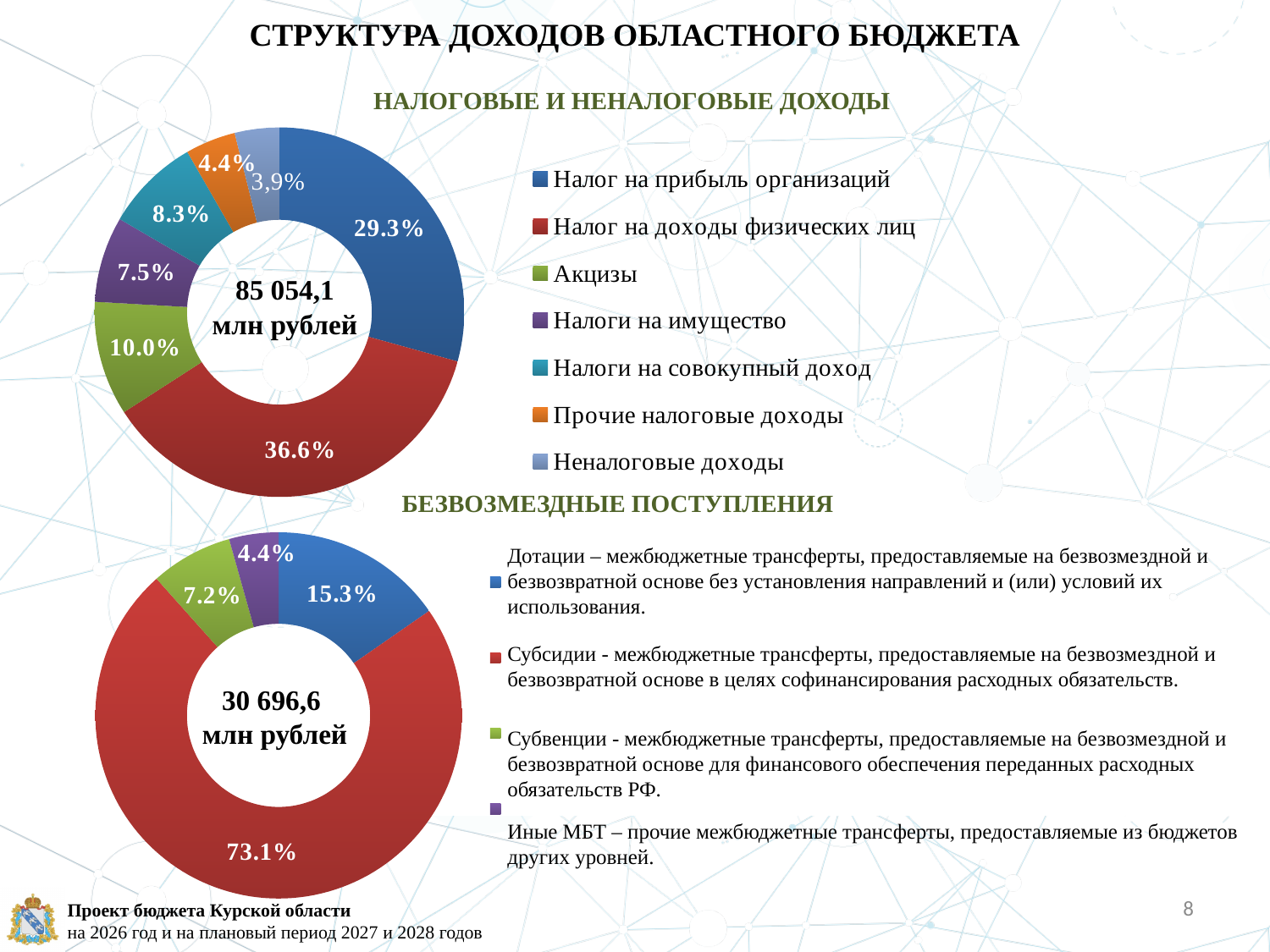
In the 'НАЛОГОВЫЕ И НЕНАЛОГОВЫЕ ДОХОДЫ' chart, which is larger: 'Налоги на совокупный доход' or 'Налоги на имущество'? Налоги на совокупный доход In the 'НАЛОГОВЫЕ И НЕНАЛОГОВЫЕ ДОХОДЫ' chart, which category has the largest share? Налог на доходы физических лиц What total amount is printed in the centre of the 'НАЛОГОВЫЕ И НЕНАЛОГОВЫЕ ДОХОДЫ' chart? 85 054,1 млн рублей In the 'БЕЗВОЗМЕЗДНЫЕ ПОСТУПЛЕНИЯ' chart, which category has the smallest share? Иные МБТ In the 'НАЛОГОВЫЕ И НЕНАЛОГОВЫЕ ДОХОДЫ' chart, what share is shown for 'Налог на доходы физических лиц'? 36.6% How many categories does the legend of the 'НАЛОГОВЫЕ И НЕНАЛОГОВЫЕ ДОХОДЫ' chart list? 7 In the 'НАЛОГОВЫЕ И НЕНАЛОГОВЫЕ ДОХОДЫ' chart, what share is shown for 'Акцизы'? 10.0% In the 'БЕЗВОЗМЕЗДНЫЕ ПОСТУПЛЕНИЯ' chart, what share is shown for 'Субсидии'? 73.1% In the 'НАЛОГОВЫЕ И НЕНАЛОГОВЫЕ ДОХОДЫ' chart, what is the difference in percentage points between 'Налог на доходы физических лиц' and 'Налог на прибыль организаций'? 7.3 What kind of chart is the 'БЕЗВОЗМЕЗДНЫЕ ПОСТУПЛЕНИЯ' chart? Pie (doughnut) chart In the 'НАЛОГОВЫЕ И НЕНАЛОГОВЫЕ ДОХОДЫ' chart, which category has the smallest share? Неналоговые доходы